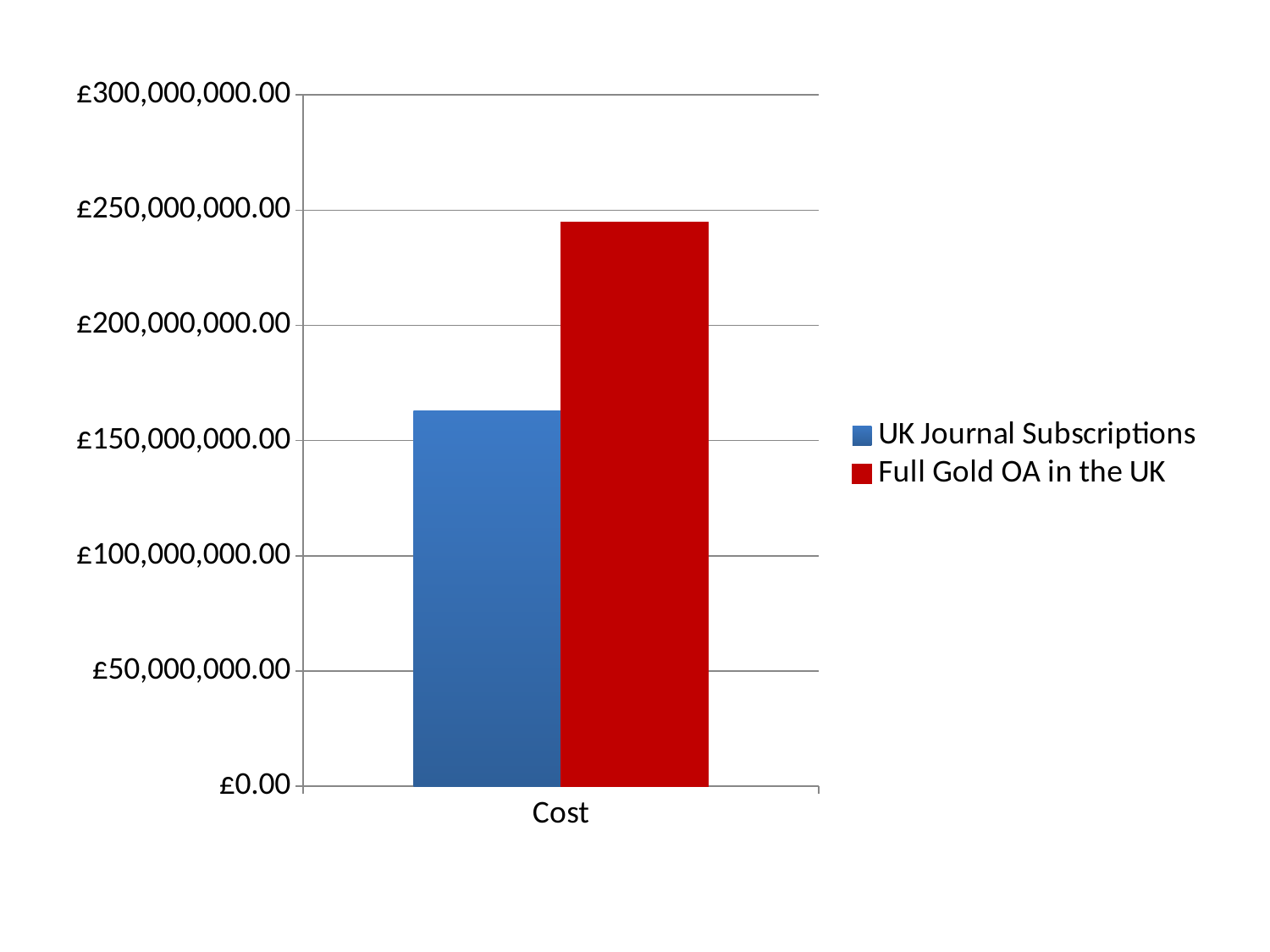
How many series does the legend list? 2 Which series has the taller bar, UK Journal Subscriptions or Full Gold OA in the UK? Full Gold OA in the UK What kind of chart is shown on the slide? bar chart Which series has the highest value? Full Gold OA in the UK Is the value for Full Gold OA in the UK greater or less than £200,000,000.00? greater Is the value for UK Journal Subscriptions greater or less than £200,000,000.00? less What colour is the bar for Full Gold OA in the UK? red Is the value for Full Gold OA in the UK greater or less than £250,000,000.00? less What is the label of the category on the x axis? Cost Which series has the lowest value? UK Journal Subscriptions How many categories are shown on the x axis? 1